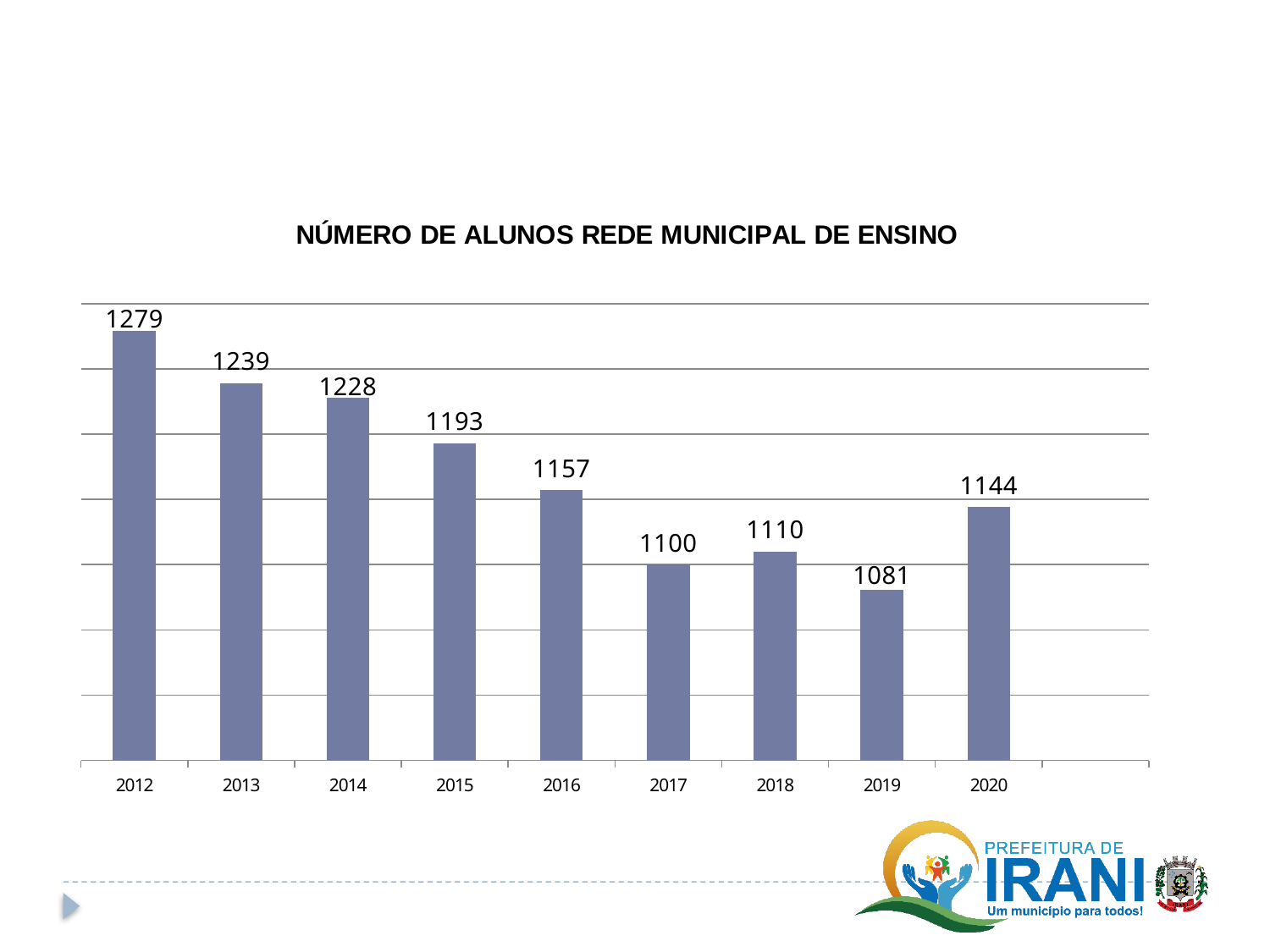
How many years are shown on the chart? 9 What is the number of students in 2016? 1157 What is the difference between the number of students in 2020 and 2019? 63 What is the number of students in 2019? 1081 What is the title of the chart? NÚMERO DE ALUNOS REDE MUNICIPAL DE ENSINO Which year has the highest number of students? 2012 What kind of chart is shown on the slide? Bar chart What is the number of students in 2012? 1279 What is the number of students in 2020? 1144 What is the difference between the number of students in 2012 and 2019? 198 Which year has the lowest number of students? 2019 Which year has more students, 2017 or 2018? 2018